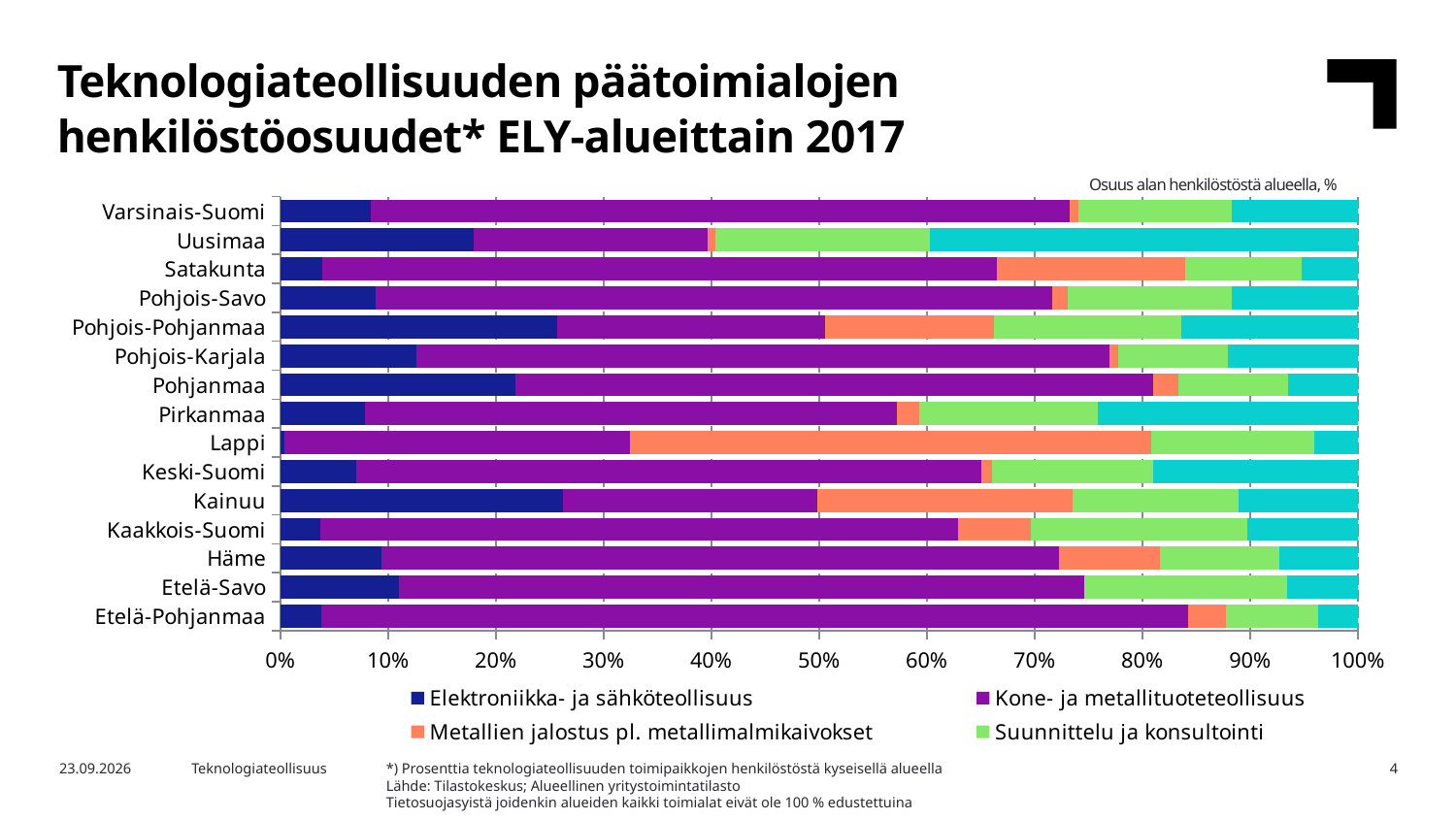
How many ELY regions are listed on the vertical axis of the chart? 15 Is the Kone- ja metallituoteteollisuus share for Etelä-Pohjanmaa greater or less than 70%? greater How many series does the chart legend list? 4 Which region has a larger Metallien jalostus pl. metallimalmikaivokset share, Lappi or Satakunta? Lappi Is the Elektroniikka- ja sähköteollisuus share for Kainuu greater or less than 20%? greater Is the Elektroniikka- ja sähköteollisuus share for Uusimaa greater or less than 20%? less What kind of chart is shown on the slide? Stacked bar chart What is the maximum value shown on the horizontal axis of the chart? 100% What is the title of the chart on the slide? Teknologiateollisuuden päätoimialojen henkilöstöosuudet* ELY-alueittain 2017 Which region has the largest share for Metallien jalostus pl. metallimalmikaivokset? Lappi Which region has a larger Elektroniikka- ja sähköteollisuus share, Pohjanmaa or Häme? Pohjanmaa